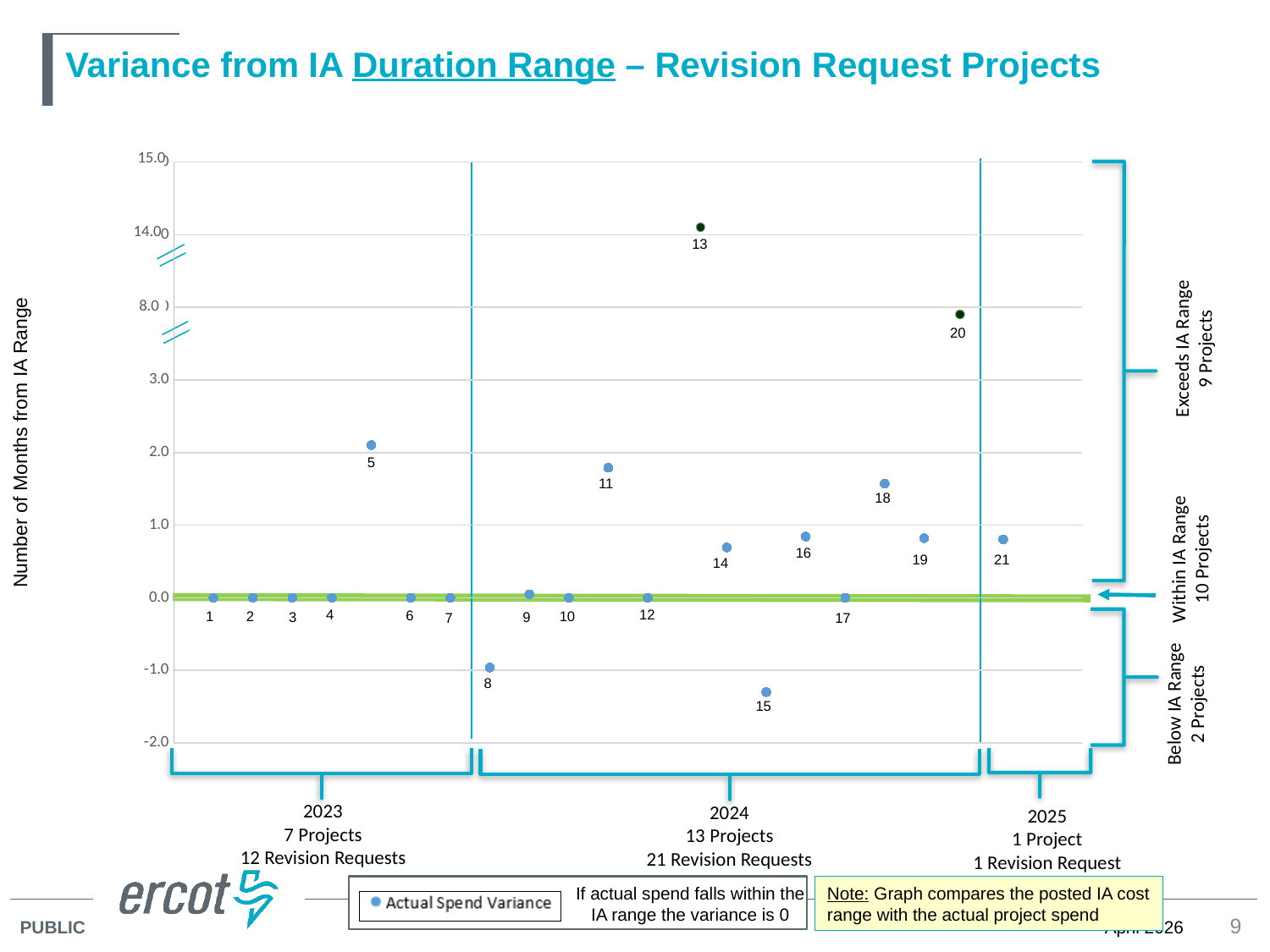
Is the value for project 14 greater or less than 1.0? less How many project points are plotted on the chart? 21 According to the annotation on the right of the chart, how many projects are within the IA range? 10 Projects What is the variance value plotted for project 1? 0.0 Which project has the lowest variance from the IA duration range? 15 What is the name of the series shown in the legend? Actual Spend Variance Which project has the highest variance from the IA duration range? 13 Is the value for project 15 greater or less than -1.0? less Is the value for project 11 greater or less than 1.0? greater What kind of chart is shown on the slide? scatter chart How many series does the legend list? 1 Which has the larger variance, project 13 or project 20? 13